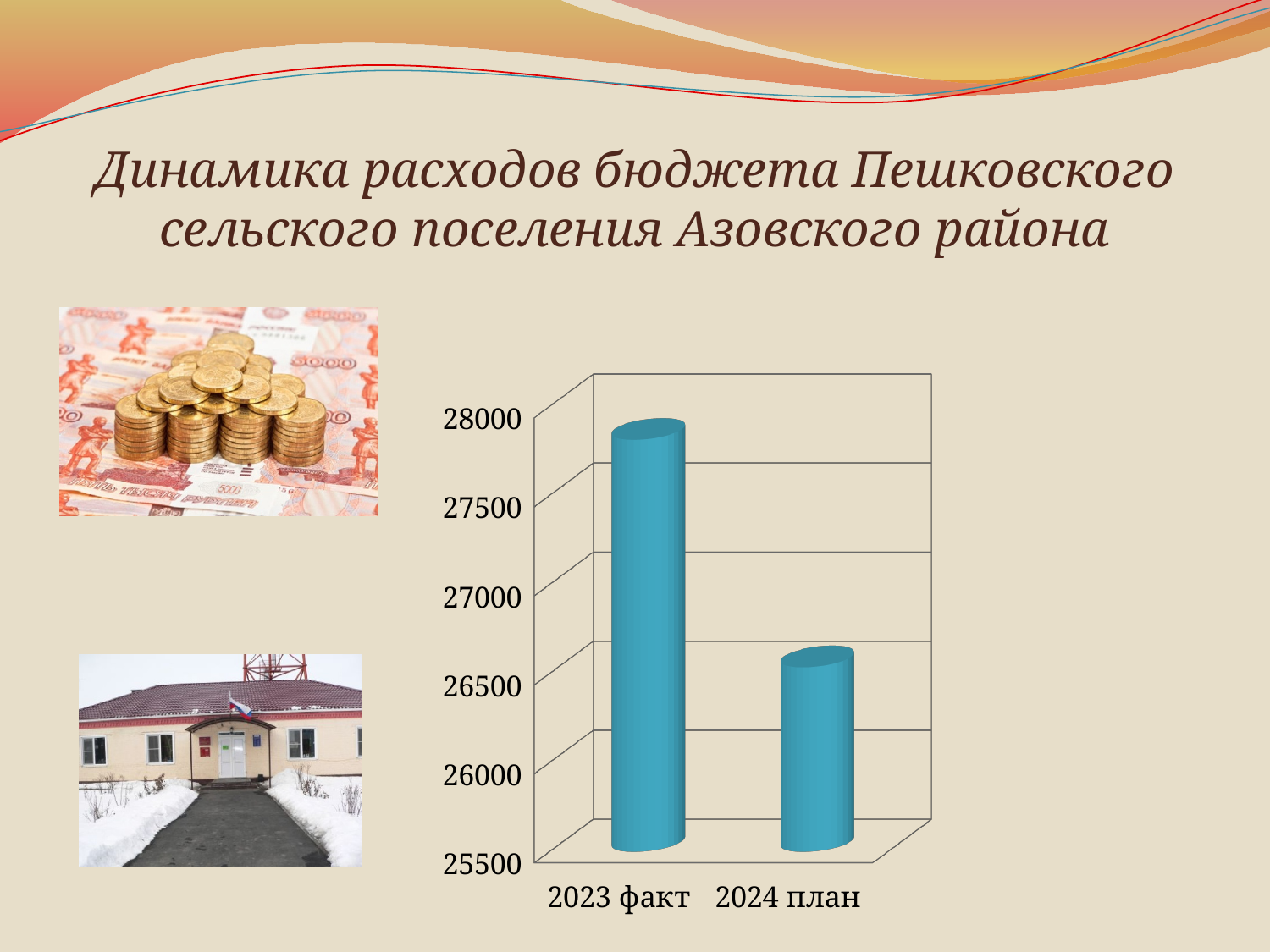
Which category has the highest value on the chart? 2023 факт Is the value for 2024 план greater or less than 27000? less Is the value for 2023 факт greater or less than 27500? greater What is the title of the slide containing the chart? Динамика расходов бюджета Пешковского сельского поселения Азовского района What kind of chart is shown on the slide? bar chart Is the value for 2023 факт greater or less than 28000? less Do the values rise or fall from 2023 факт to 2024 план? fall Which category has the lowest value on the chart? 2024 план What is the lowest value shown on the chart's vertical axis? 25500 Which is larger, the value for 2023 факт or the value for 2024 план? 2023 факт How many categories are plotted on the chart? 2